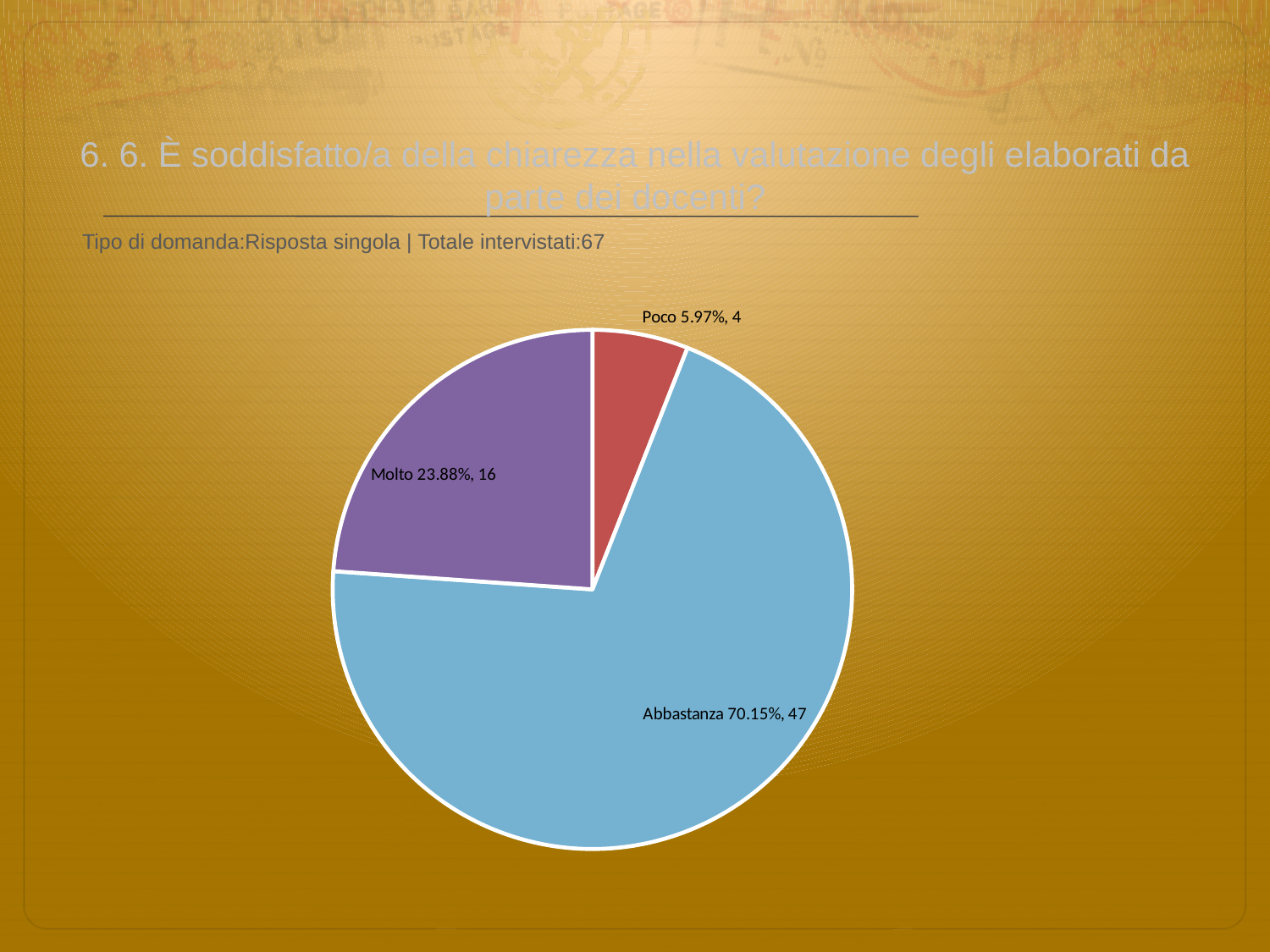
How many slices does the pie chart have? 3 What percentage share does the Poco slice have? 5.97% What kind of chart is shown on the slide? pie chart What is the difference in respondent count between Abbastanza and Molto? 31 What is the total number of respondents across all slices? 67 How many respondents answered Poco? 4 What colour is the Molto slice? purple What percentage share does the Abbastanza slice have? 70.15% How many respondents answered Molto? 16 Which category has the smallest slice? Poco Which has more respondents, Molto or Poco? Molto Which category has the largest slice? Abbastanza